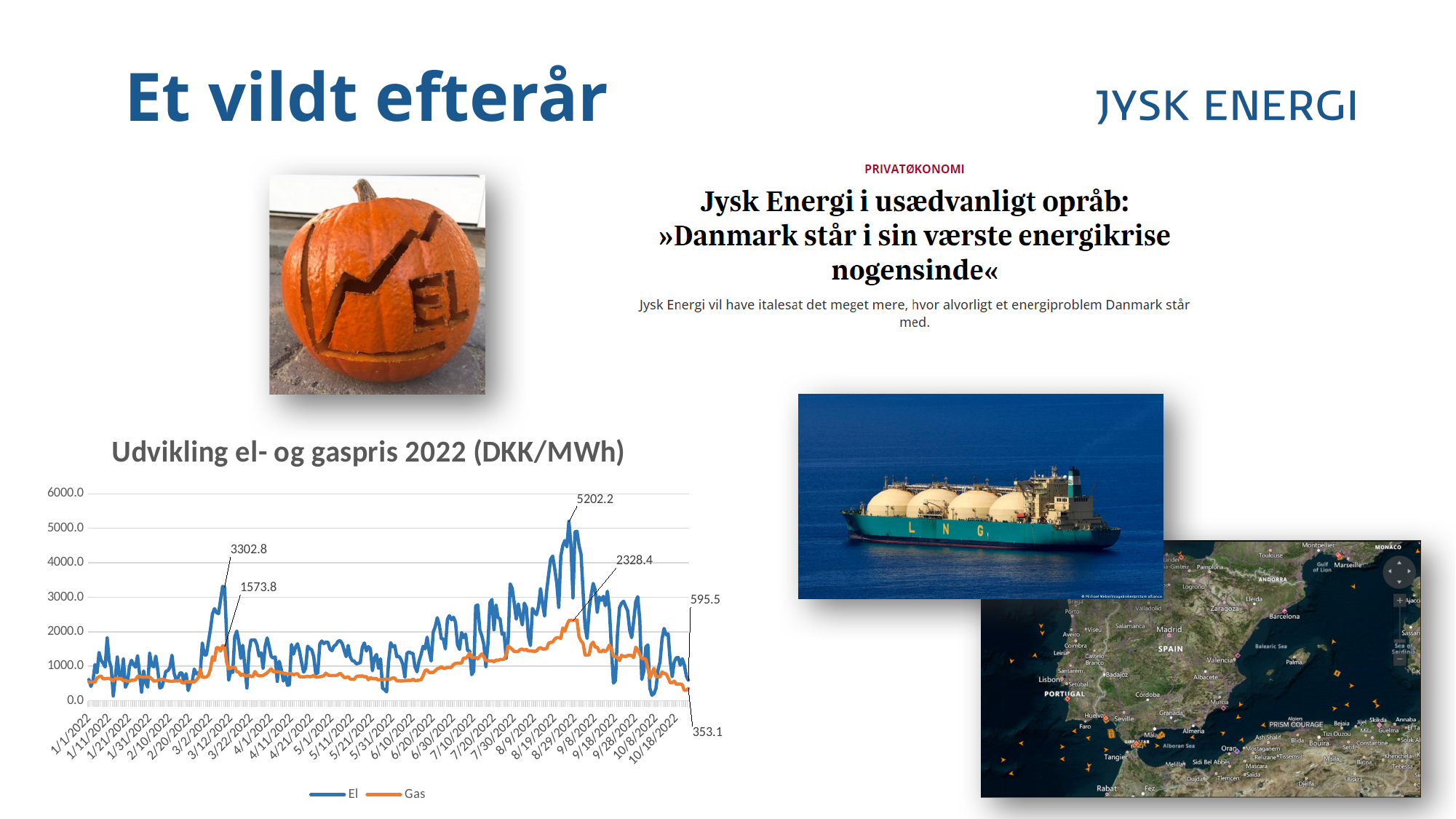
What are the two series named in the chart legend? El and Gas What is the last labelled value of the Gas series at the right end of the chart? 353.1 What is the title of the chart? Udvikling el- og gaspris 2022 (DKK/MWh) How many series does the legend of the chart list? 2 What is the difference between the labelled El peak of 5202.2 and the labelled Gas peak of 2328.4? 2873.8 What kind of chart is shown on the slide? line chart What is the labelled peak value of the El series in March 2022? 3302.8 What is the highest labelled value of the Gas series? 2328.4 At the right end of the chart, which series has the higher labelled value, El (595.5) or Gas (353.1)? El What is the labelled peak value of the Gas series in March 2022? 1573.8 Is the peak value of the Gas series greater or less than 3000.0? less What is the highest labelled value of the El series? 5202.2